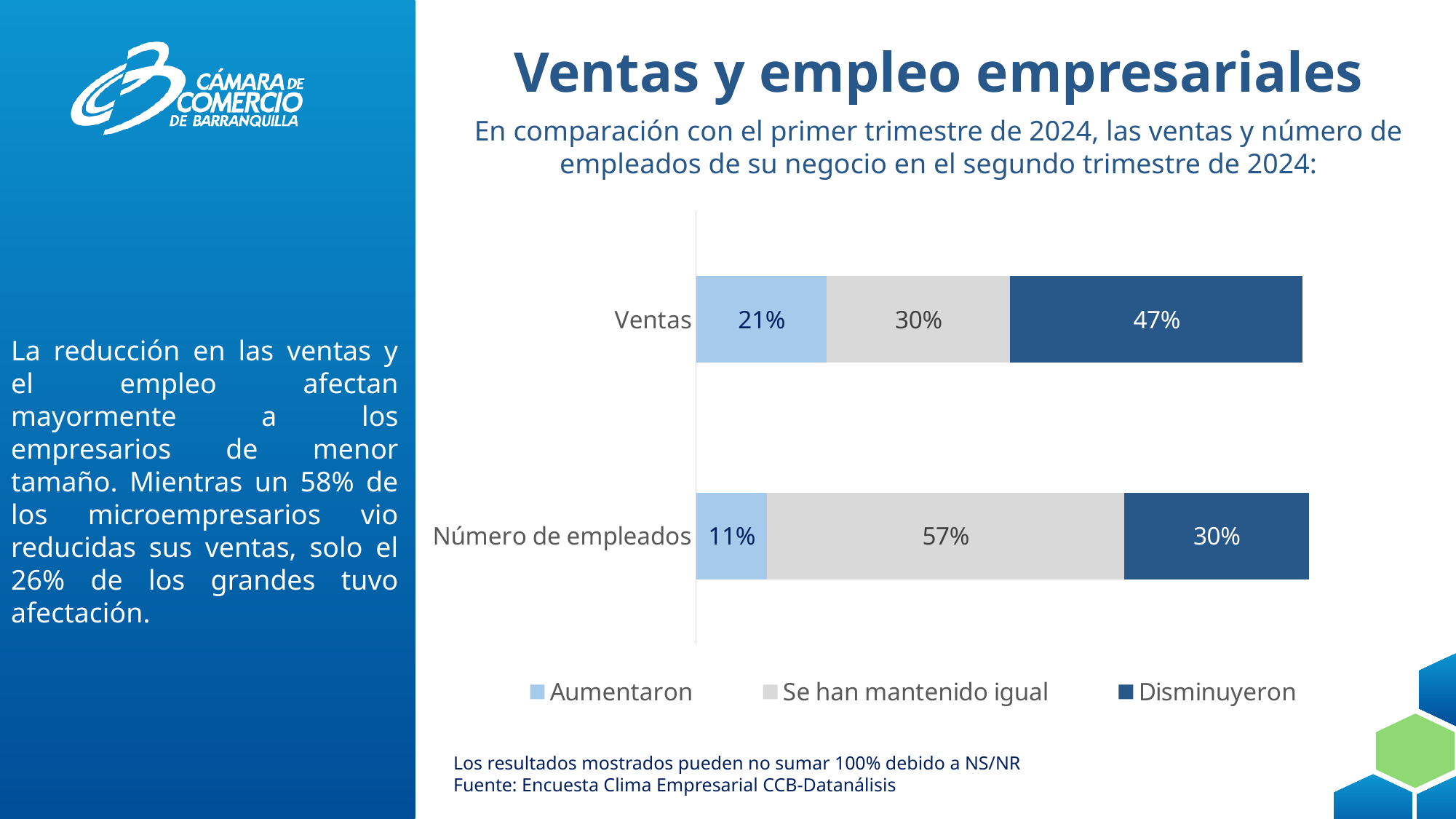
What kind of chart is shown on the slide? Stacked bar chart What percentage of respondents said Número de empleados 'Se han mantenido igual'? 57% What is the value for 'Aumentaron' in the Número de empleados bar? 11% Which category has the higher 'Disminuyeron' value, Ventas or Número de empleados? Ventas What percentage of respondents said Ventas 'Disminuyeron'? 47% What is the value for 'Aumentaron' in the Ventas bar? 21% How many series does the legend list? 3 Which response is the smallest segment in the Número de empleados bar? Aumentaron How many categories are shown on the chart? 2 Which response is the largest segment in the Ventas bar? Disminuyeron What is the difference between the 'Disminuyeron' values for Ventas and Número de empleados? 17 percentage points What is the difference between the 'Se han mantenido igual' values for Número de empleados and Ventas? 27 percentage points